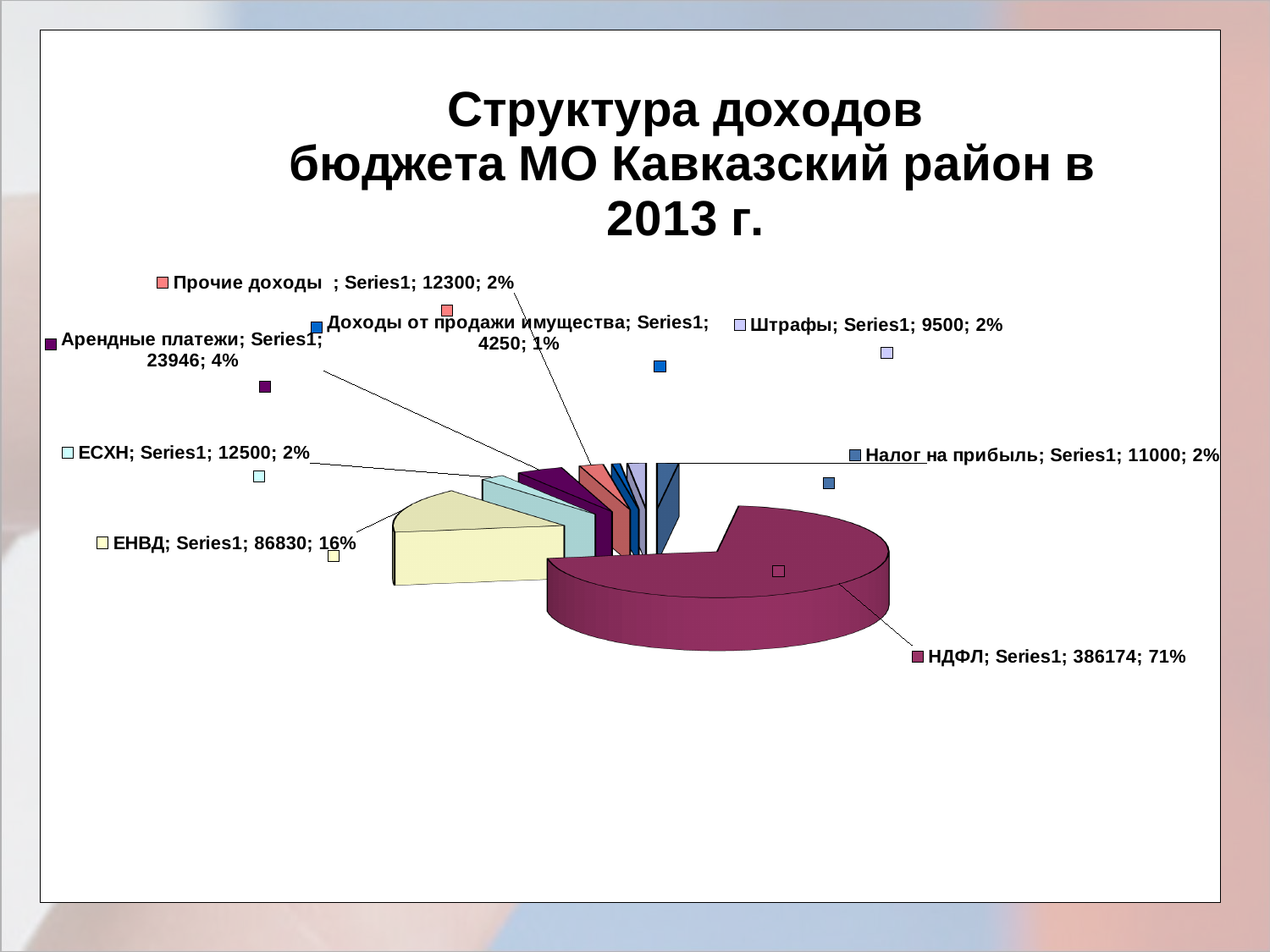
What is the value for Арендные платежи? 23946 What is the value for Доходы от продажи имущества? 4250 What share of the pie does НДФЛ represent? 71% What share of the pie does ЕНВД represent? 16% How many categories are shown in the pie chart? 8 What type of chart is shown on the slide? pie chart What is the value for НДФЛ? 386174 Which is larger, the value for Штрафы or the value for Налог на прибыль? Налог на прибыль What is the value for ЕНВД? 86830 What is the difference between the values for ЕСХН and Прочие доходы? 200 Which category has the largest slice of the pie? НДФЛ Which category has the smallest slice of the pie? Доходы от продажи имущества